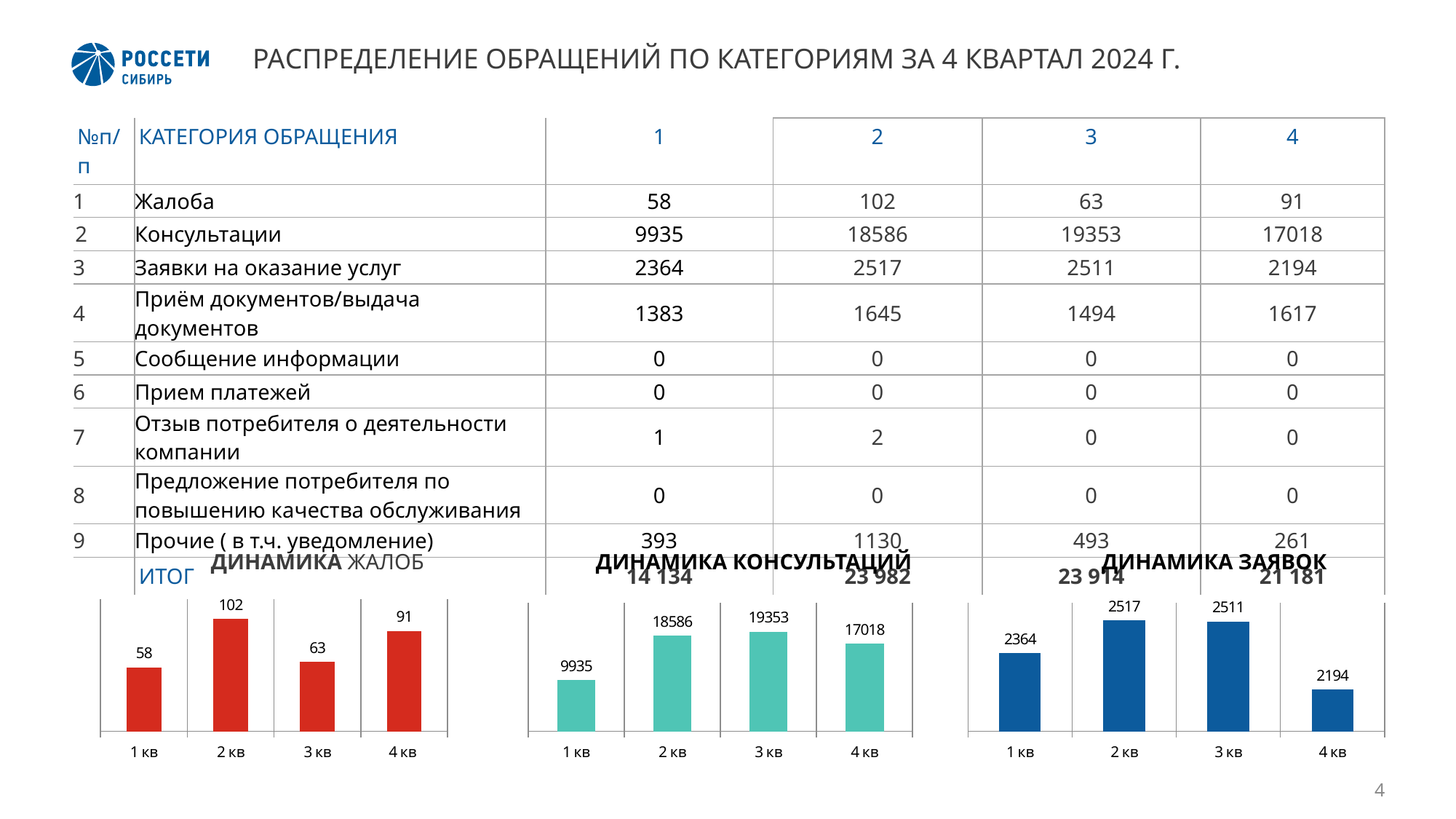
What type of chart is the chart titled ДИНАМИКА ЖАЛОБ? bar chart In the chart titled ДИНАМИКА ЗАЯВОК, what is the value for 4 кв? 2194 In the chart titled ДИНАМИКА ЖАЛОБ, what is the difference between the values for 2 кв and 1 кв? 44 In the chart titled ДИНАМИКА ЗАЯВОК, which quarter has the lowest value? 4 кв In the chart titled ДИНАМИКА ЖАЛОБ, what is the value for 2 кв? 102 In the chart titled ДИНАМИКА ЖАЛОБ, which quarter has the lowest value? 1 кв In the chart titled ДИНАМИКА КОНСУЛЬТАЦИЙ, which quarter has the highest value? 3 кв In the chart titled ДИНАМИКА ЗАЯВОК, how many quarters are plotted? 4 How many bar charts are shown on the slide? 3 In the chart titled ДИНАМИКА КОНСУЛЬТАЦИЙ, what is the difference between the values for 2 кв and 1 кв? 8651 In the chart titled ДИНАМИКА КОНСУЛЬТАЦИЙ, which is larger, the value for 2 кв or the value for 4 кв? 2 кв In the chart titled ДИНАМИКА КОНСУЛЬТАЦИЙ, what is the value for 3 кв? 19353